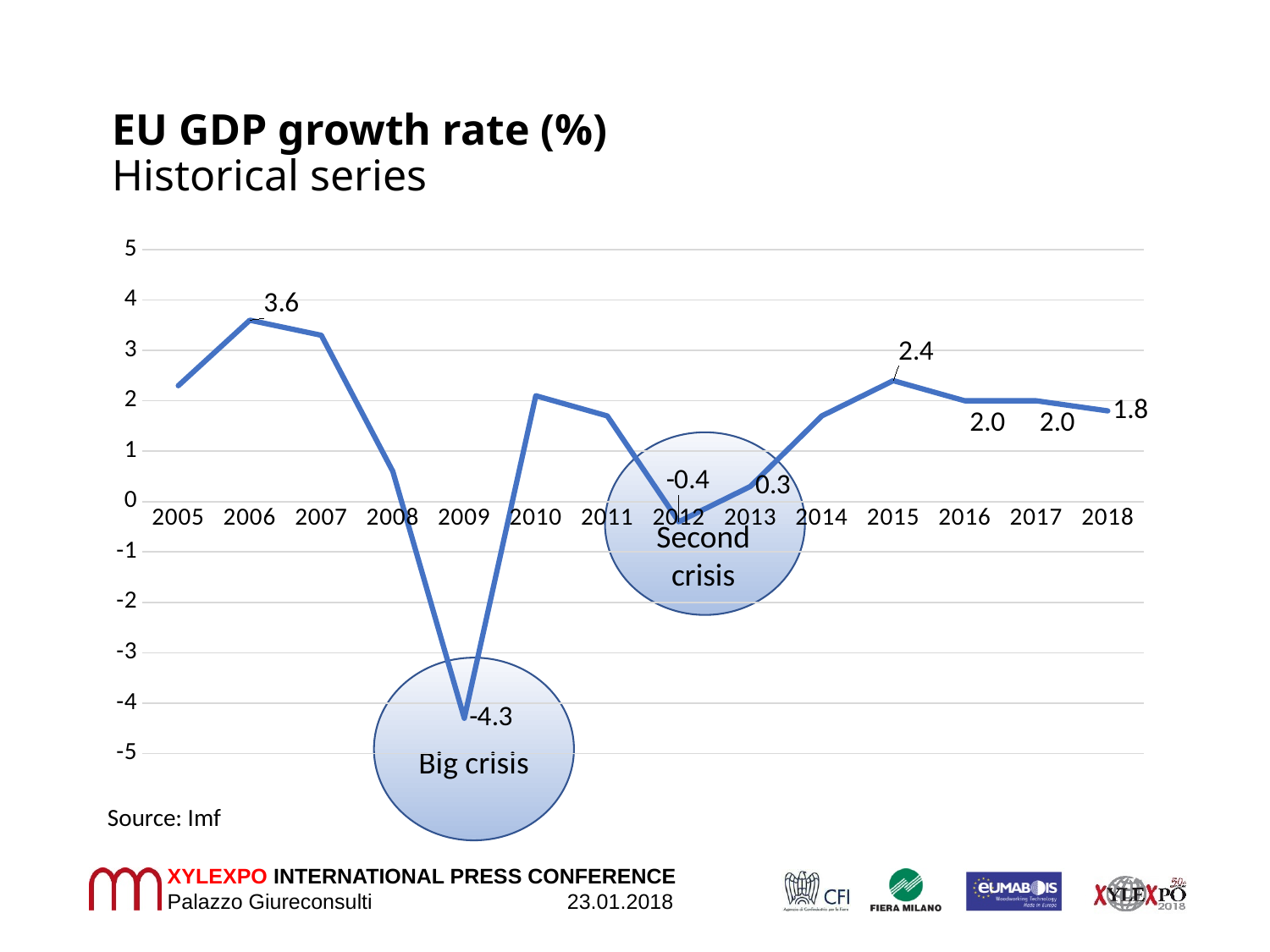
What is the EU GDP growth rate shown for 2015? 2.4 What is the EU GDP growth rate shown for 2018? 1.8 Which year has the larger growth rate, 2012 or 2013? 2013 Is the value for 2008 greater or less than 1? less What is the EU GDP growth rate shown for 2006? 3.6 What is the difference between the growth rate in 2015 and in 2018? 0.6 Does the growth rate rise or fall from 2015 to 2018? Fall Is the value for 2011 greater or less than 2? less What is the EU GDP growth rate shown for 2009? -4.3 How many years are shown on the x axis of the chart? 14 What kind of chart is shown on the slide? Line chart Which year has the lowest EU GDP growth rate on the chart? 2009